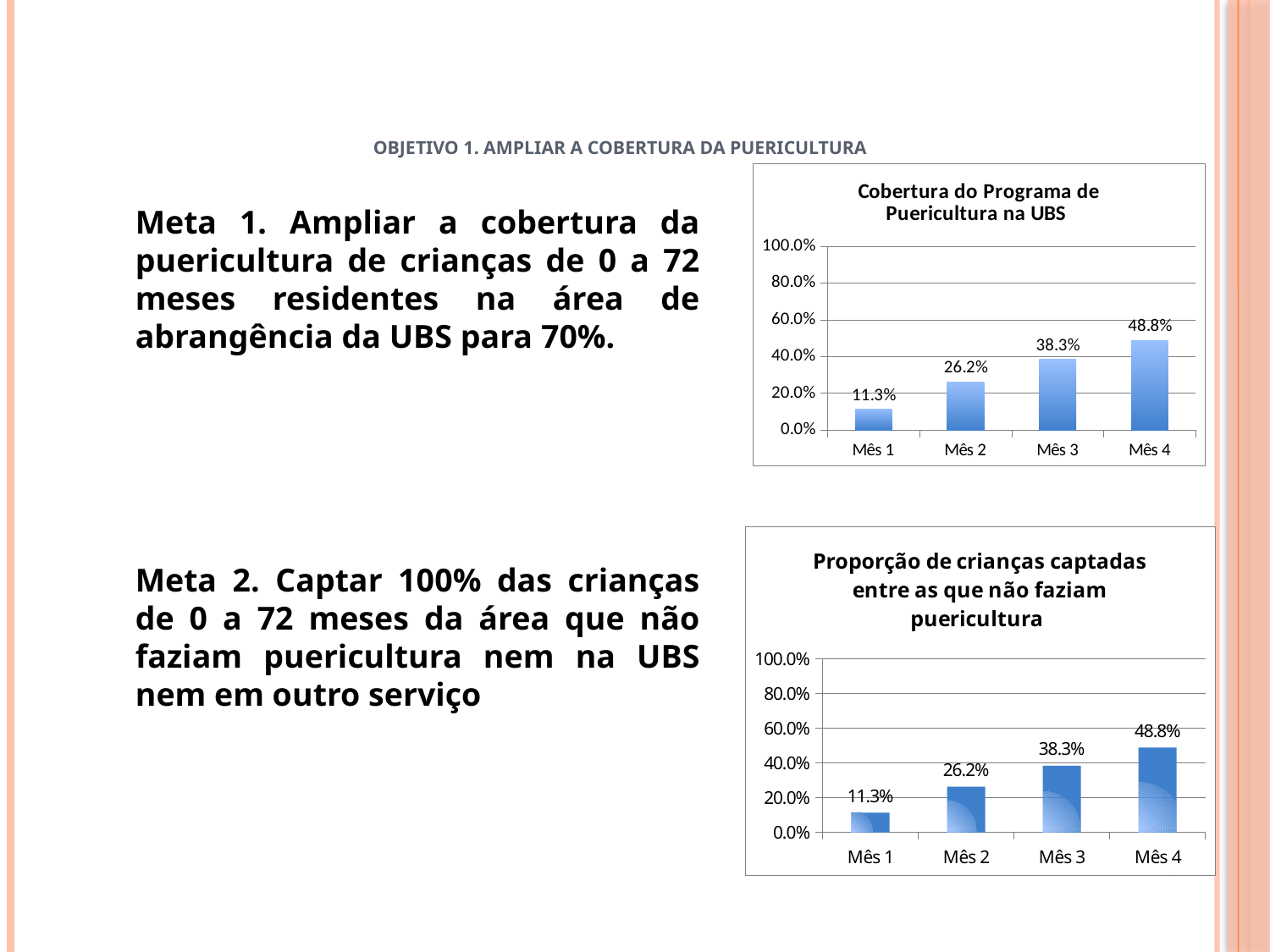
In the chart titled "Proporção de crianças captadas entre as que não faziam puericultura", what is the difference between the values for Mês 3 and Mês 2? 12.1% In the chart titled "Proporção de crianças captadas entre as que não faziam puericultura", what is the value for Mês 2? 26.2% In the chart titled "Cobertura do Programa de Puericultura na UBS", what is the difference between the values for Mês 4 and Mês 1? 37.5% In the chart titled "Proporção de crianças captadas entre as que não faziam puericultura", what is the value for Mês 4? 48.8% In the chart titled "Cobertura do Programa de Puericultura na UBS", which month has the lowest value? Mês 1 In the chart titled "Cobertura do Programa de Puericultura na UBS", do the values rise or fall from Mês 1 to Mês 4? rise In the chart titled "Proporção de crianças captadas entre as que não faziam puericultura", which is larger, the value for Mês 2 or Mês 3? Mês 3 In the chart titled "Proporção de crianças captadas entre as que não faziam puericultura", is the value for Mês 4 greater or less than 60.0%? less In the chart titled "Cobertura do Programa de Puericultura na UBS", which month has the highest value? Mês 4 In the chart titled "Cobertura do Programa de Puericultura na UBS", how many months are shown on the x axis? 4 In the chart titled "Cobertura do Programa de Puericultura na UBS", what is the value for Mês 3? 38.3% What kind of chart is the chart titled "Cobertura do Programa de Puericultura na UBS"? bar chart